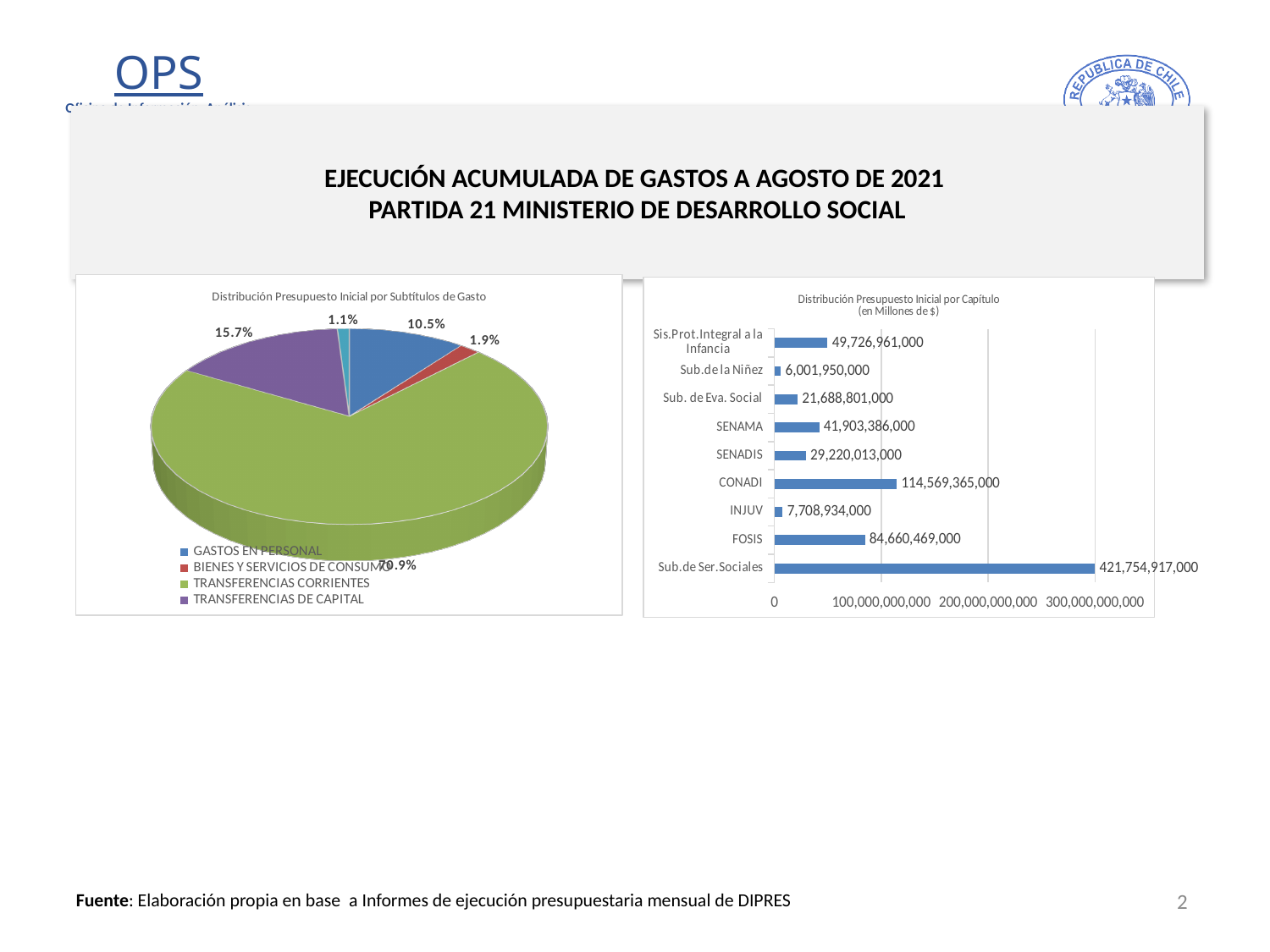
In the pie chart 'Distribución Presupuesto Inicial por Subtítulos de Gasto', what share does TRANSFERENCIAS DE CAPITAL have? 15.7% In the pie chart 'Distribución Presupuesto Inicial por Subtítulos de Gasto', how many entries does the legend list? 4 In the bar chart 'Distribución Presupuesto Inicial por Capítulo', which category has the lowest value? Sub.de la Niñez What kind of chart is 'Distribución Presupuesto Inicial por Capítulo'? Bar chart In the pie chart 'Distribución Presupuesto Inicial por Subtítulos de Gasto', what share does GASTOS EN PERSONAL have? 10.5% In the pie chart 'Distribución Presupuesto Inicial por Subtítulos de Gasto', what share does TRANSFERENCIAS CORRIENTES have? 70.9% In the bar chart 'Distribución Presupuesto Inicial por Capítulo', what is the value for CONADI? 114,569,365,000 What kind of chart is the chart on the left of the slide? Pie chart In the bar chart 'Distribución Presupuesto Inicial por Capítulo', what is the value for SENADIS? 29,220,013,000 In the bar chart 'Distribución Presupuesto Inicial por Capítulo', which category has the highest value? Sub.de Ser.Sociales In the pie chart 'Distribución Presupuesto Inicial por Subtítulos de Gasto', which legend category has the largest slice? TRANSFERENCIAS CORRIENTES In the bar chart 'Distribución Presupuesto Inicial por Capítulo', how many categories are shown? 9